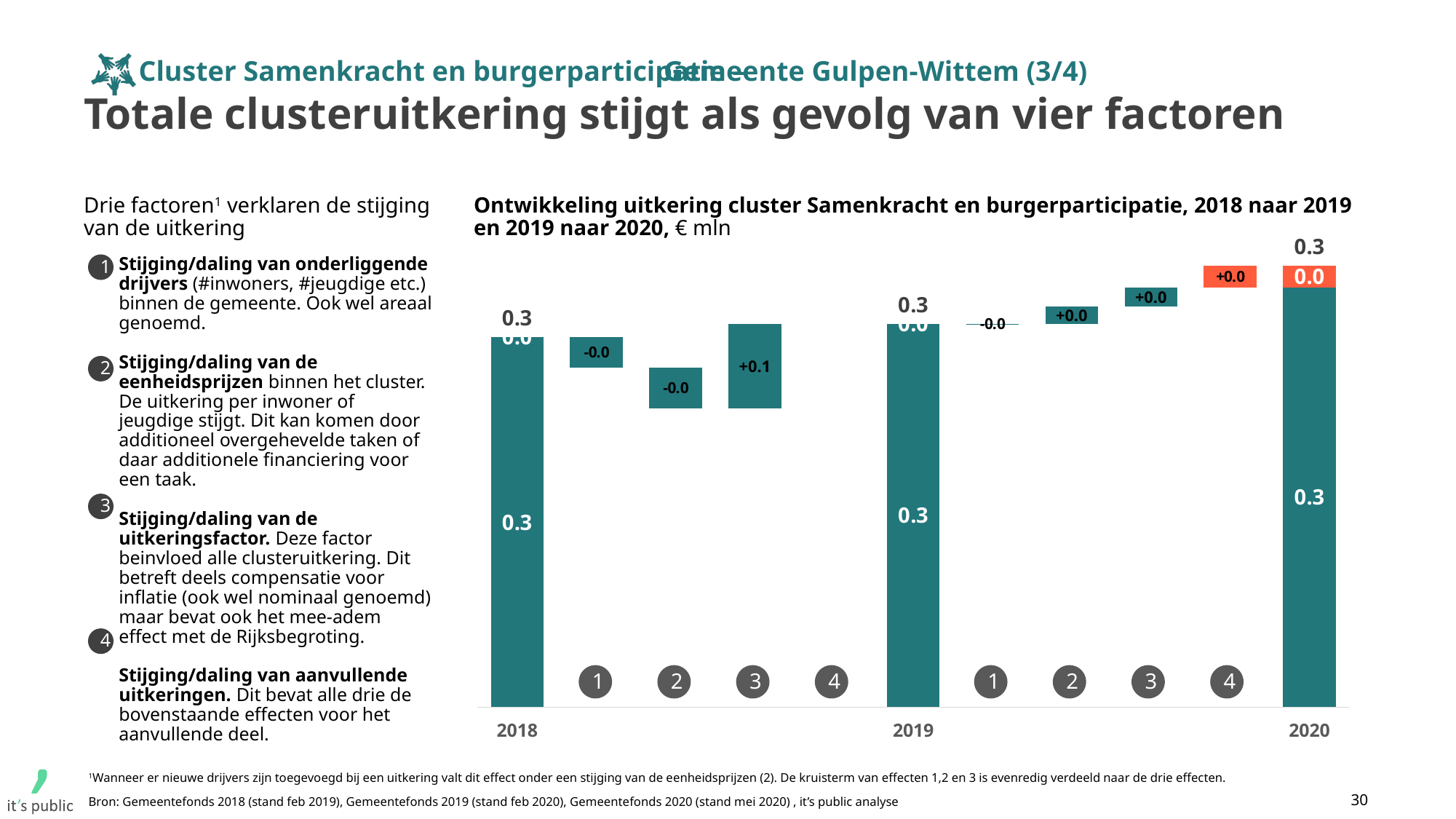
What is the total value shown above the 2020 bar? 0.3 Which factor has the largest value in the 2018 to 2019 bridge? Factor 3 What is the total value shown above the 2018 bar? 0.3 What kind of chart is shown on the slide? bar chart (waterfall) How many year totals (full bars) are shown in the chart? 3 What colour is the bar for factor 4 in the 2019 to 2020 bridge? Orange What is the value of factor 3 in the 2018 to 2019 bridge? +0.1 Which is larger in the 2018 to 2019 bridge: factor 3 or factor 1? Factor 3 In what unit are the values in the chart expressed? € mln What is the value of factor 1 in the 2018 to 2019 bridge? -0.0 What is the value of factor 2 in the 2019 to 2020 bridge? +0.0 What is the value of factor 4 (orange bar) in the 2019 to 2020 bridge? +0.0